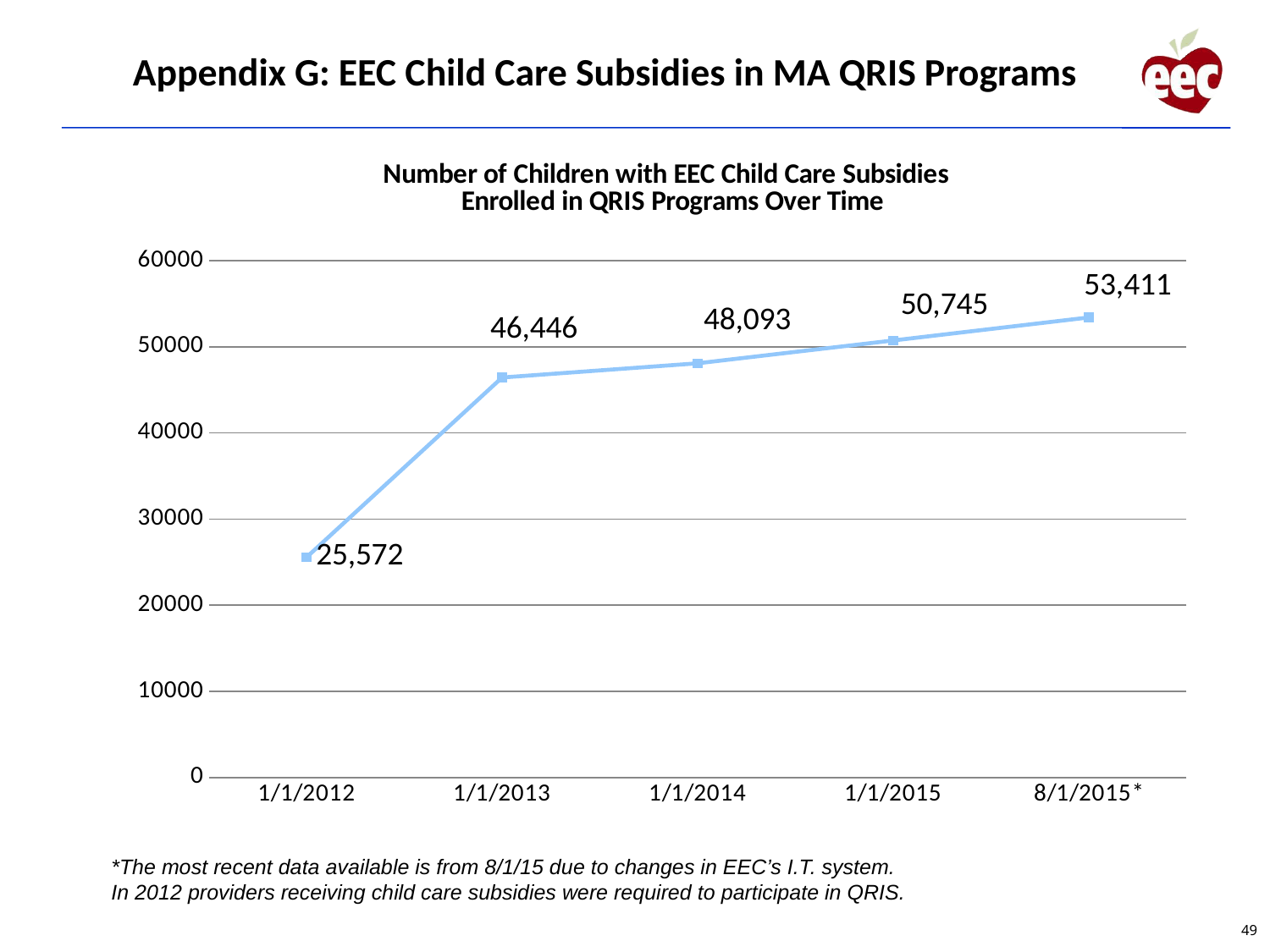
What is the value plotted for 8/1/2015*? 53,411 Is the value for 1/1/2013 greater or less than 40000? greater What is the difference between the values for 1/1/2013 and 1/1/2012? 20,874 Which date has the highest number of children enrolled? 8/1/2015* What is the number of children with EEC child care subsidies enrolled in QRIS programs on 1/1/2012? 25,572 Which date has the lowest number of children enrolled? 1/1/2012 How many data points are plotted on the chart? 5 Do the values rise or fall from 1/1/2012 to 8/1/2015*? Rise What is the value plotted for 1/1/2014? 48,093 What kind of chart is shown on the slide? Line chart Which is larger, the value for 1/1/2015 or the value for 1/1/2014? 1/1/2015 What is the difference between the values for 8/1/2015* and 1/1/2015? 2,666